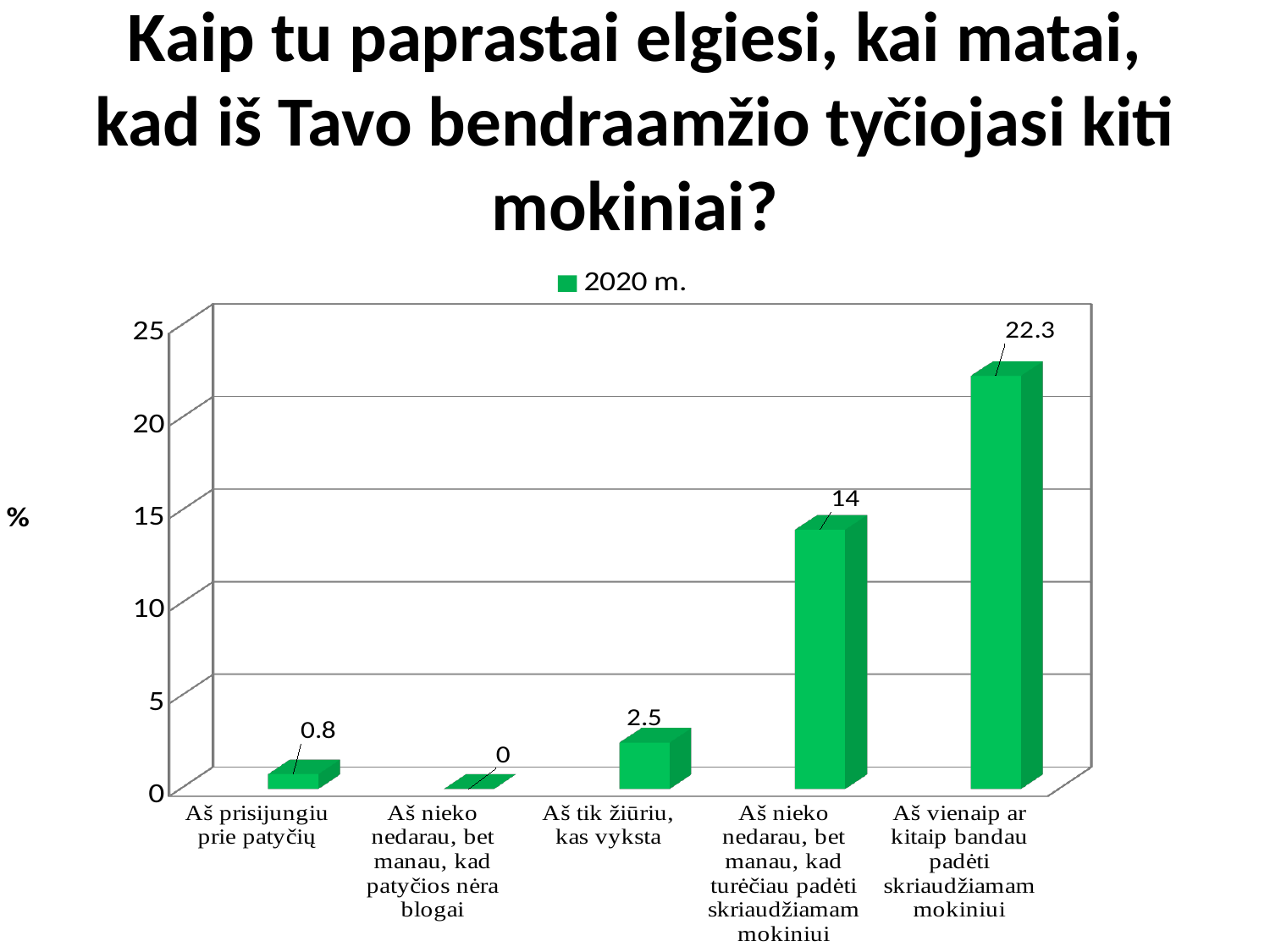
How many categories are shown on the x axis? 5 What is the value for "Aš vienaip ar kitaip bandau padėti skriaudžiamam mokiniui"? 22.3 What kind of chart is shown on the slide? bar chart What is the value for "Aš prisijungiu prie patyčių"? 0.8 What is the difference between the values for "Aš vienaip ar kitaip bandau padėti skriaudžiamam mokiniui" and "Aš nieko nedarau, bet manau, kad turėčiau padėti skriaudžiamam mokiniui"? 8.3 How many series does the legend list? 1 What is the value for "Aš nieko nedarau, bet manau, kad turėčiau padėti skriaudžiamam mokiniui"? 14 Which category has the highest value? Aš vienaip ar kitaip bandau padėti skriaudžiamam mokiniui What is the value for "Aš tik žiūriu, kas vyksta"? 2.5 Which is larger: the value for "Aš tik žiūriu, kas vyksta" or the value for "Aš prisijungiu prie patyčių"? Aš tik žiūriu, kas vyksta Is the value for "Aš nieko nedarau, bet manau, kad turėčiau padėti skriaudžiamam mokiniui" greater or less than 10? greater Which category has the lowest value? Aš nieko nedarau, bet manau, kad patyčios nėra blogai